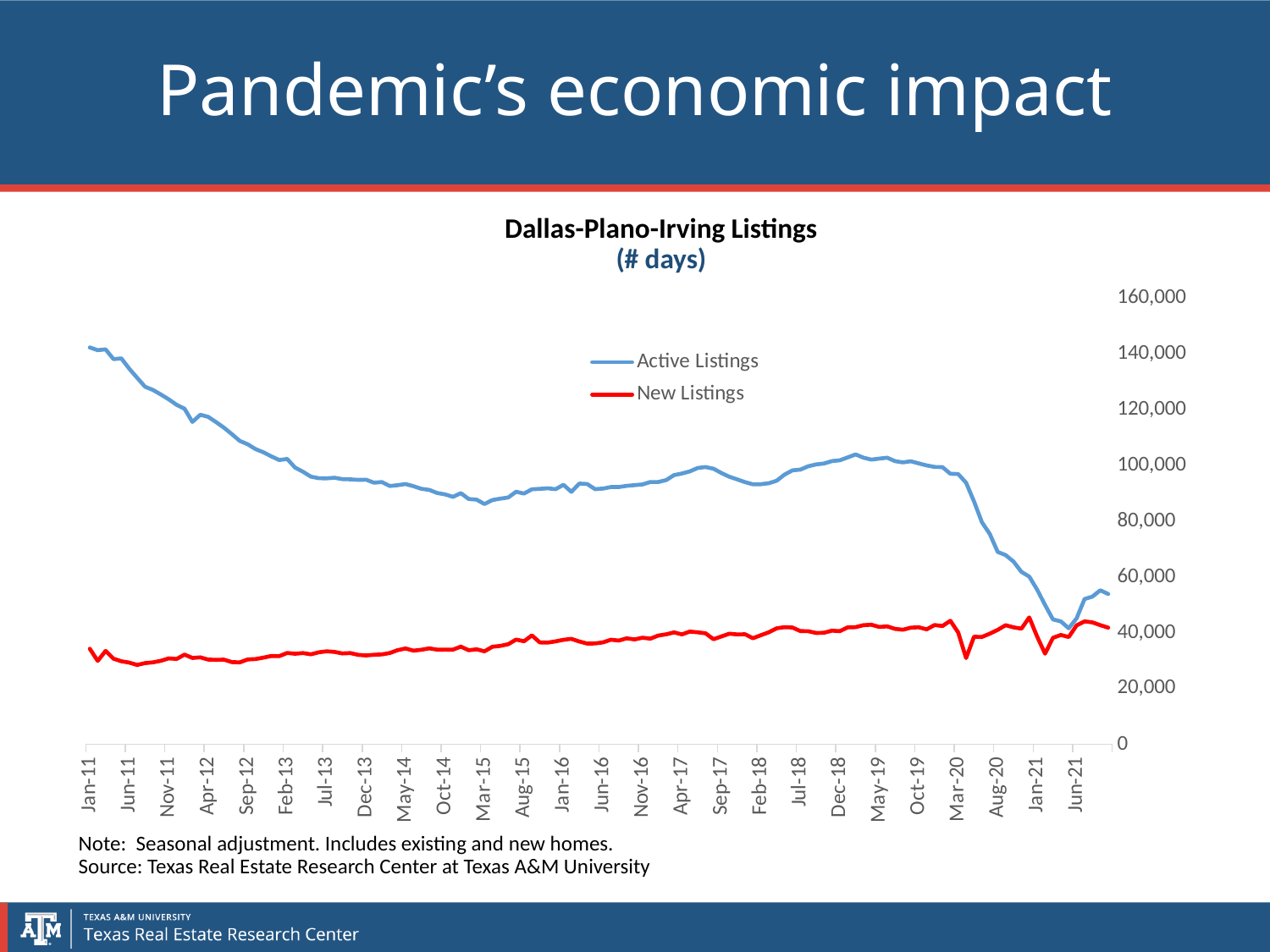
What are the two series named in the chart's legend? Active Listings and New Listings Which series has the larger value in Jan-11, Active Listings or New Listings? Active Listings Is the value for Active Listings in Dec-18 greater or less than 80,000? greater What kind of chart is shown on the slide? Line chart What is the title of the chart? Dallas-Plano-Irving Listings (# days) Is the value for Active Listings in Jan-21 greater or less than 60,000? less Is the value for Active Listings in Jan-11 greater or less than 120,000? greater How many series does the chart's legend list? 2 Does the Active Listings series overall rise or fall from Jan-11 to Jun-21? fall At which x-axis label does the Active Listings series reach its highest value? Jan-11